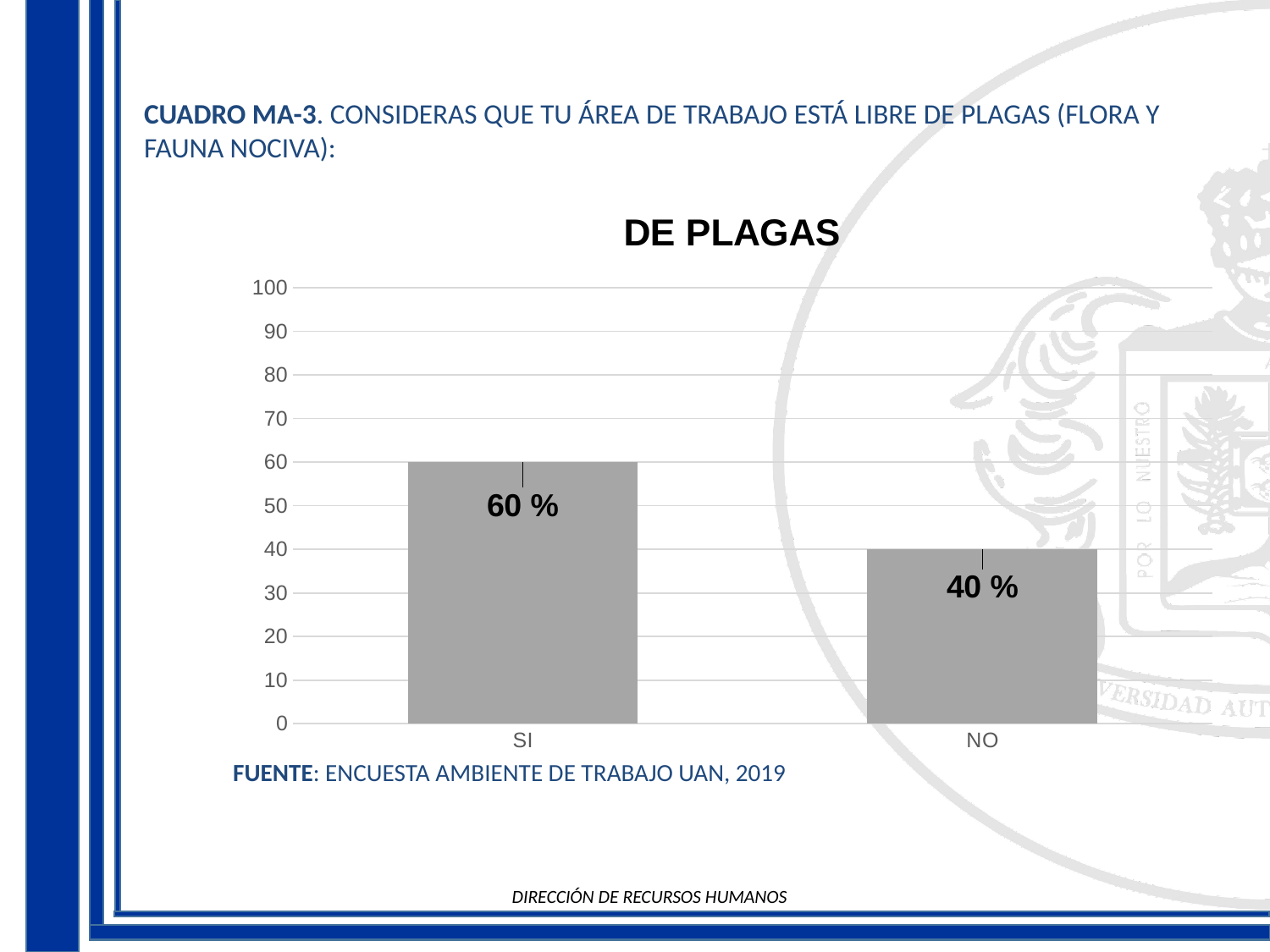
How many categories are shown on the x axis? 2 What kind of chart is shown? bar chart Is the value for SI greater or less than 50? greater What is the title of the chart? DE PLAGAS What is the value for NO? 40 % Which category has the highest value? SI What is the difference between the values for SI and NO? 20 % What is the maximum value shown on the vertical axis? 100 Which is larger, the value for SI or the value for NO? SI Which category has the lowest value? NO What is the value for SI? 60 % Is the value for NO greater or less than 50? less